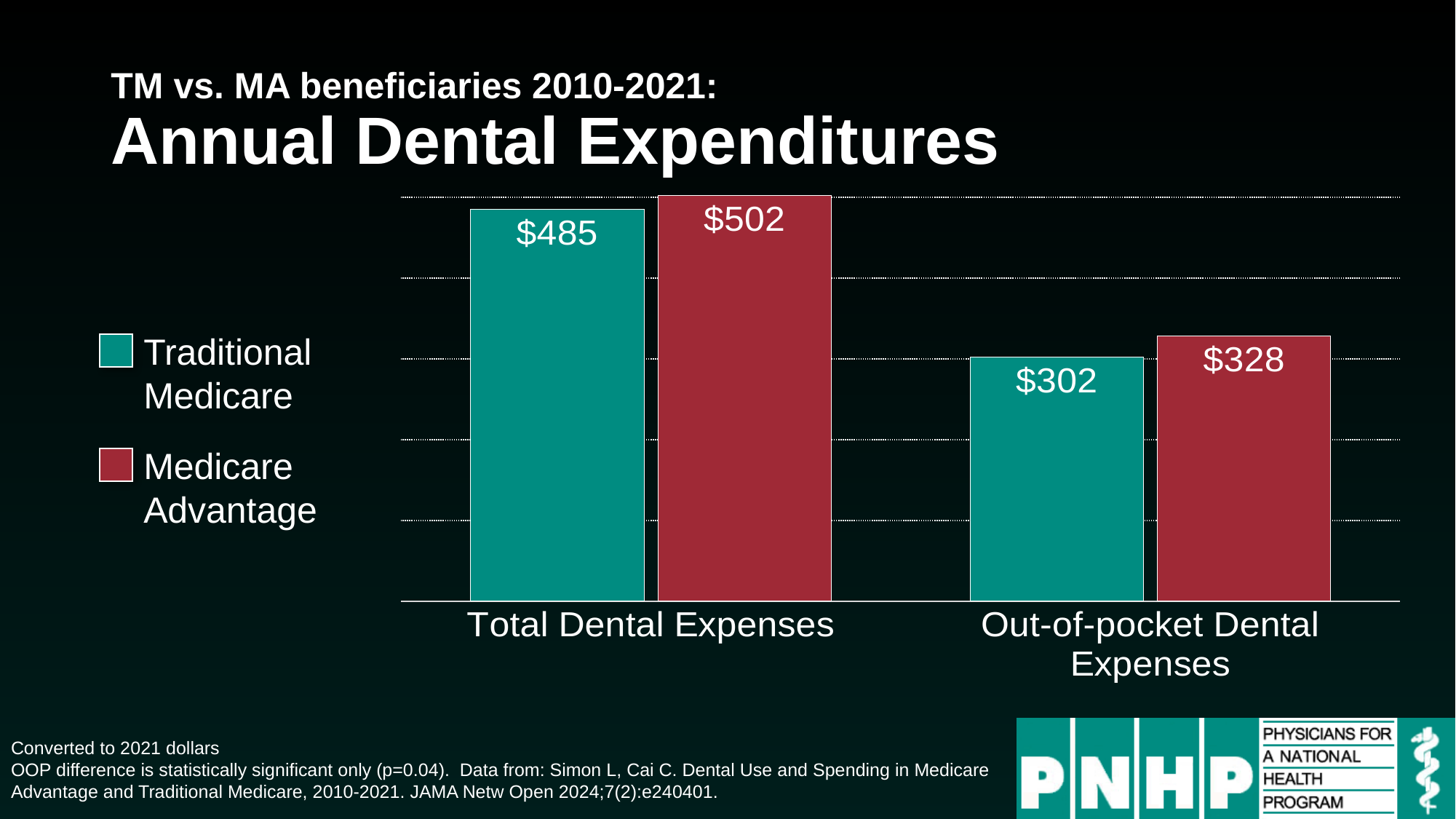
How many series does the legend list? 2 What is the value for Traditional Medicare in Total Dental Expenses? $485 What is the value for Traditional Medicare in Out-of-pocket Dental Expenses? $302 What is the difference between Medicare Advantage and Traditional Medicare for Total Dental Expenses? $17 Which is larger for Out-of-pocket Dental Expenses, Traditional Medicare or Medicare Advantage? Medicare Advantage What is the difference between Medicare Advantage and Traditional Medicare for Out-of-pocket Dental Expenses? $26 What is the value for Medicare Advantage in Out-of-pocket Dental Expenses? $328 Which bar has the lowest value in the chart? Traditional Medicare, Out-of-pocket Dental Expenses What kind of chart is shown on the slide? Bar chart What is the value for Medicare Advantage in Total Dental Expenses? $502 Which series has the highest value in the chart? Medicare Advantage How many categories are shown on the x axis? 2